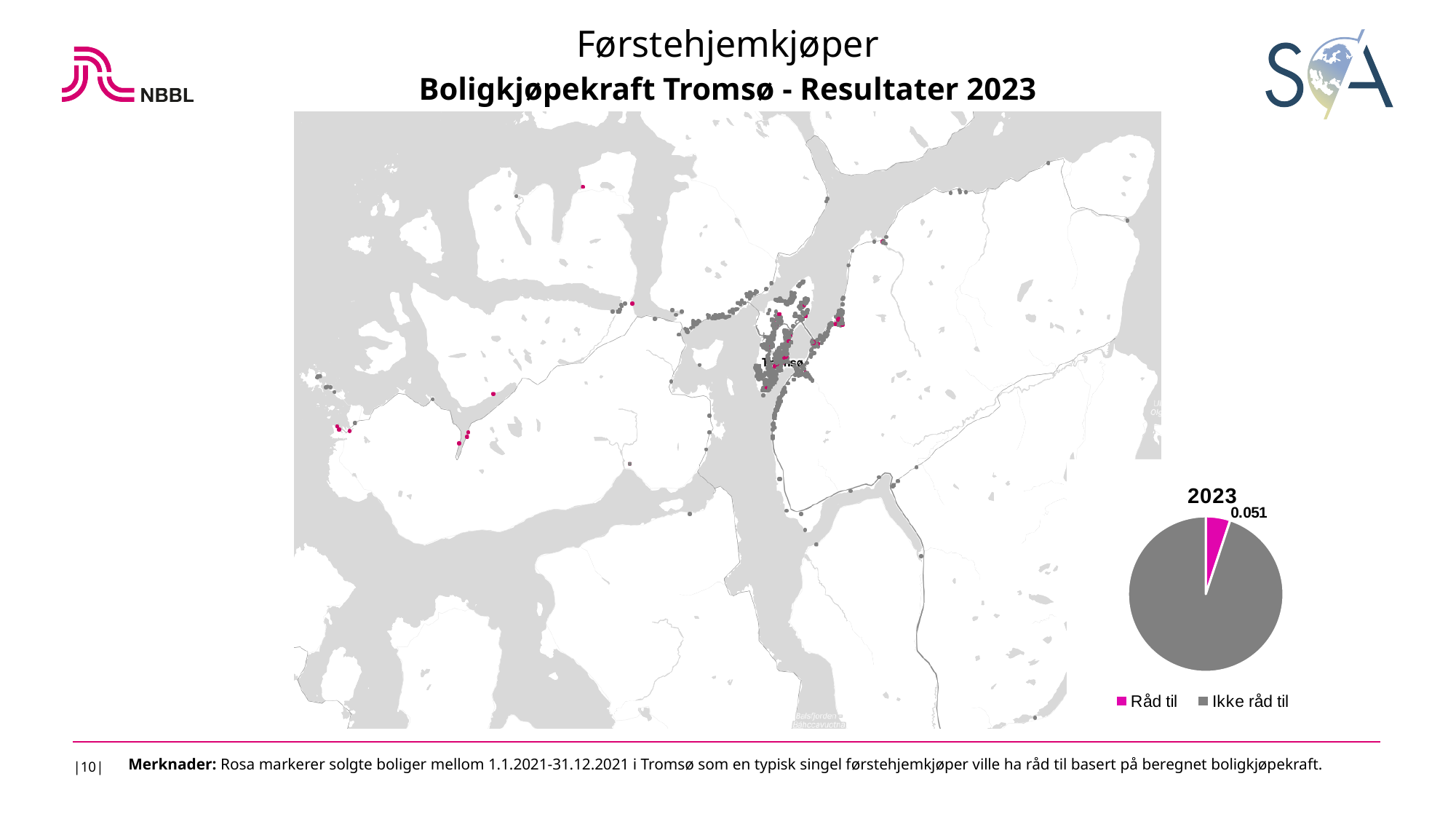
Which slice of the pie chart is the smallest? Råd til In the pie chart, which is larger: 'Råd til' or 'Ikke råd til'? Ikke råd til What kind of chart is shown in the lower right of the slide? pie chart How many slices does the pie chart have? 2 What is the title of the pie chart? 2023 What colour is the 'Råd til' slice in the pie chart? pink In the pie chart, what value is printed for the 'Råd til' slice? 0.051 What share of the pie does the 'Råd til' slice represent, as labelled on the chart? 0.051 How many categories does the pie chart's legend list? 2 Which slice of the pie chart is the largest? Ikke råd til